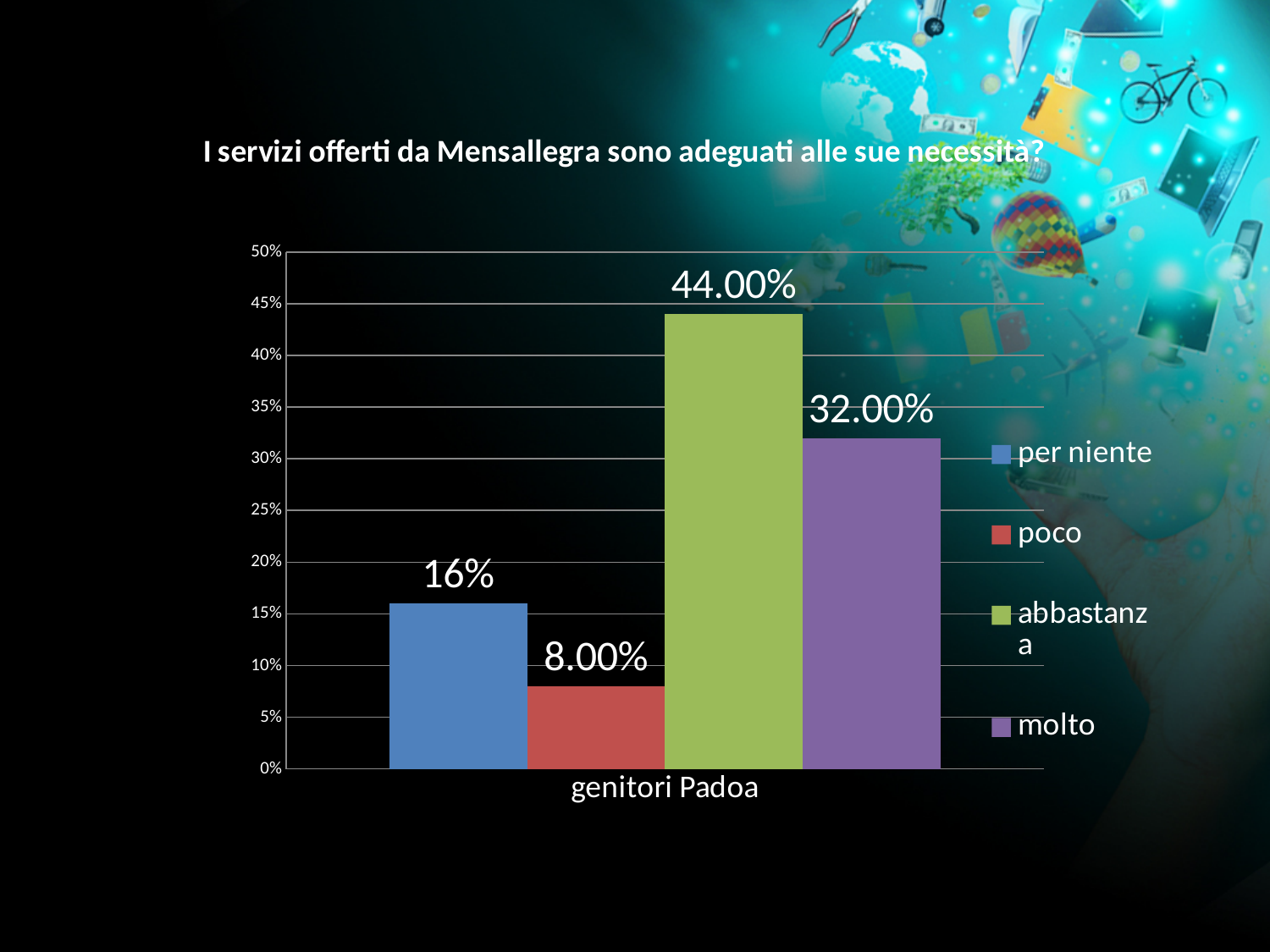
What is the difference between the values for "abbastanza" and "molto"? 12.00% What is the value for "per niente"? 16% How many series does the legend list? 4 Which series has the lowest value? poco What is the value for "molto"? 32.00% What kind of chart is shown on the slide? bar chart What is the category label shown on the x axis? genitori Padoa Is the value for "molto" greater or less than 30%? greater What is the value for "abbastanza" in the genitori Padoa chart? 44.00% Which series has the highest value? abbastanza Which is larger, the value for "per niente" or the value for "poco"? per niente What is the value for "poco"? 8.00%